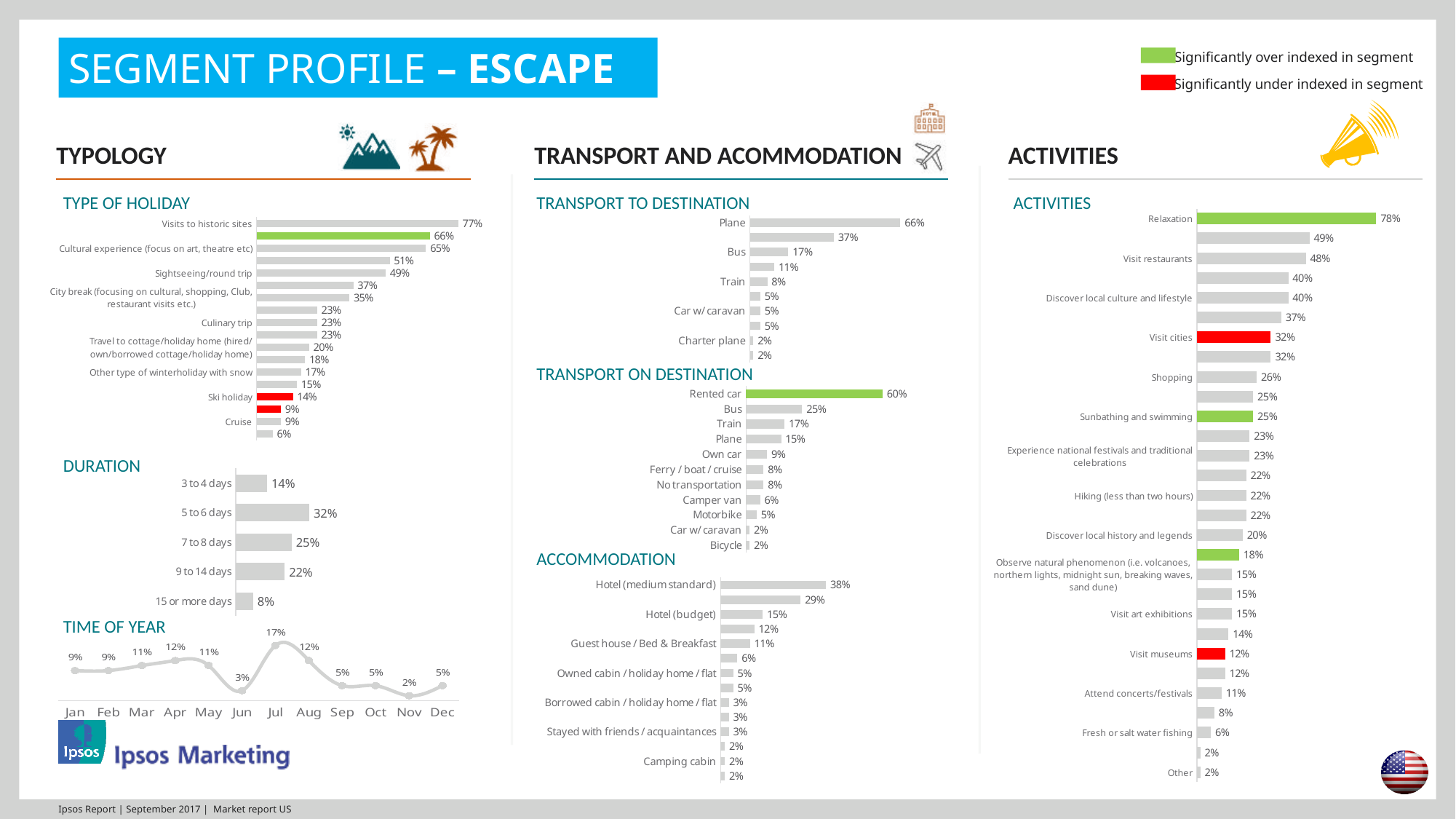
In the Transport on Destination chart, how many categories are shown? 11 In the Activities chart, which is larger, Visit cities or Shopping? Visit cities In the Type of Holiday chart, what is the value for Ski holiday? 14% In the Activities chart, which activity has the highest value? Relaxation What kind of chart is the Time of Year chart? line chart In the Transport to Destination chart, what is the value for Plane? 66% In the Accommodation chart, what is the value for Hotel (medium standard)? 38% In the Time of Year chart, what is the value for Nov? 2% In the Duration chart, which duration category has the lowest value? 15 or more days In the Time of Year chart, which month has the highest value? Jul In the Duration chart, what is the value for 5 to 6 days? 32% In the Transport on Destination chart, what is the difference between Rented car and Bus? 35%